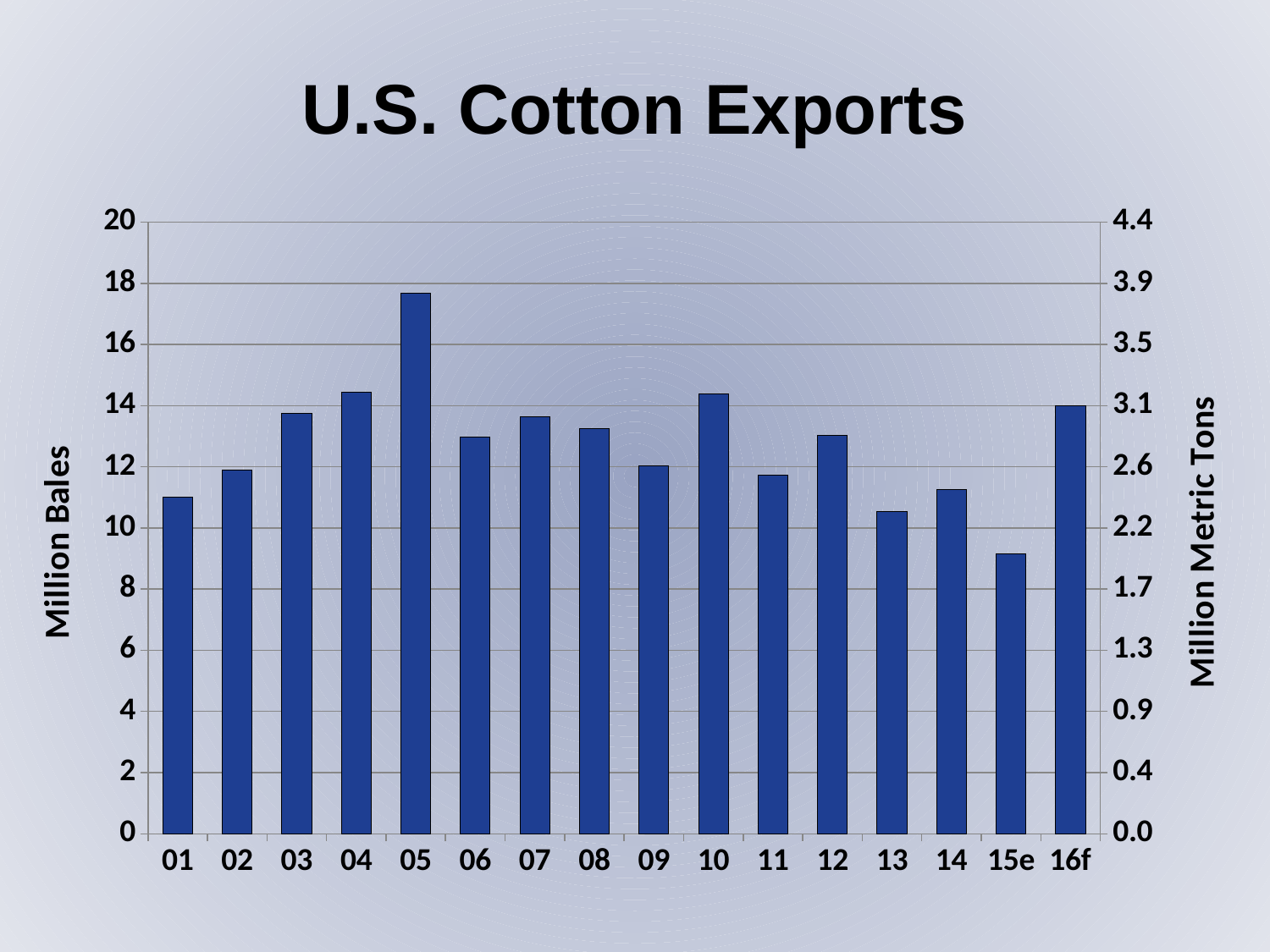
What is the title of the chart? U.S. Cotton Exports Is the value for 05 greater or less than 16 million bales? greater Which year has the lowest cotton exports? 15e Which year has larger exports, 05 or 10? 05 Do the values rise or fall from 01 to 05? rise What type of chart is shown on the slide? bar chart What is the label of the left vertical axis? Million Bales Is the value for 15e greater or less than 10 million bales? less Which year has larger exports, 14 or 15e? 14 How many years (categories) are plotted on the x axis? 16 Which year has the highest cotton exports? 05 Is the value for 01 greater or less than 10 million bales? greater